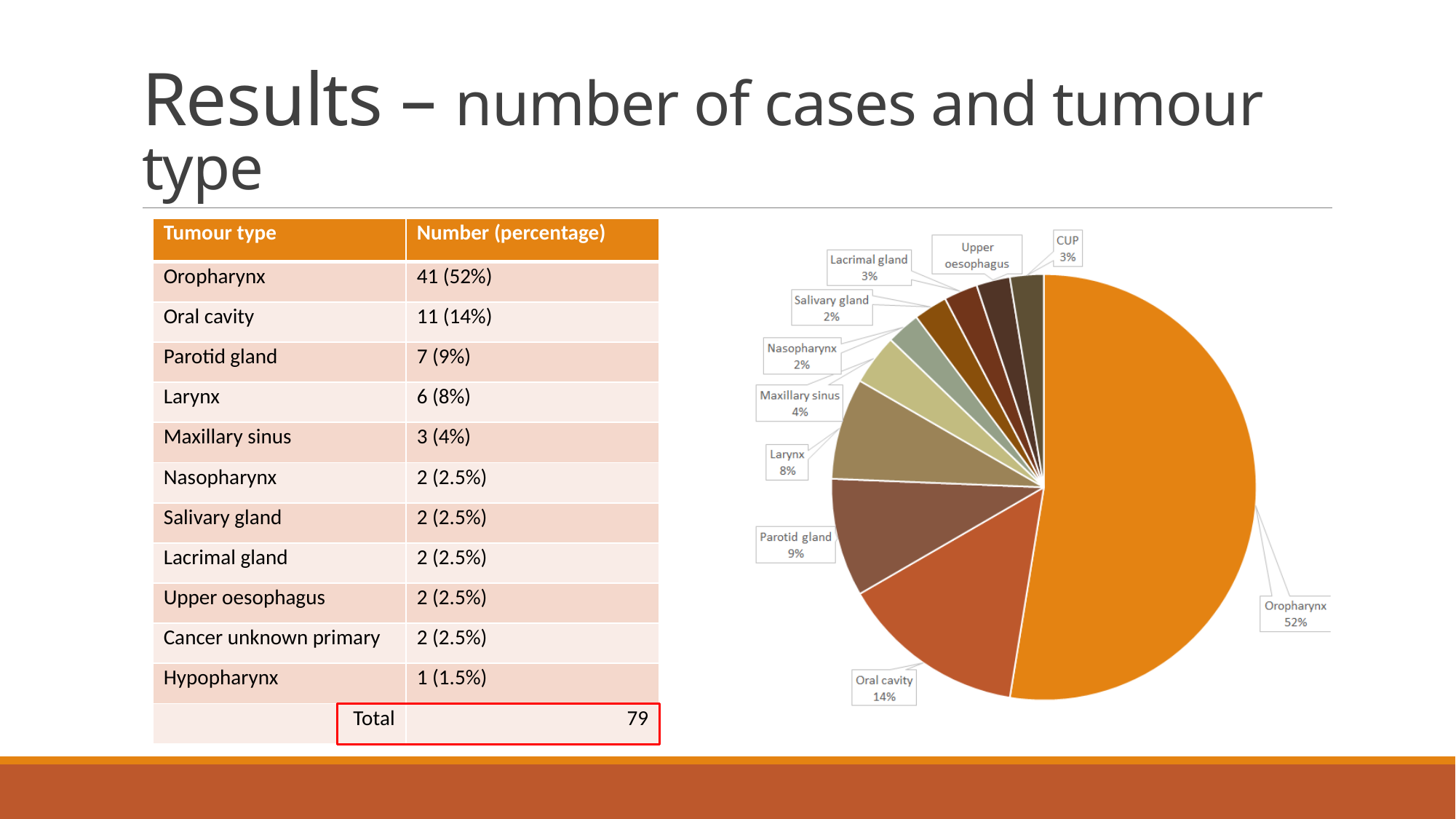
In the pie chart, what percentage is shown for Oral cavity? 14% In the pie chart, which slice is larger: Oral cavity or Parotid gland? Oral cavity In the pie chart, what percentage is shown for Larynx? 8% In the pie chart, what percentage is shown for Lacrimal gland? 3% Which tumour type has the largest slice in the pie chart? Oropharynx In the pie chart, what percentage is shown for Oropharynx? 52% In the pie chart, what is the difference in percentage points between the Oropharynx slice and the Oral cavity slice? 38 What kind of chart is shown on the slide? pie chart What share of the pie chart does the Oropharynx slice represent? 52% In the pie chart, what percentage is shown for Maxillary sinus? 4% In the pie chart, what percentage is shown for Parotid gland? 9% In the pie chart, what percentage is shown for CUP? 3%